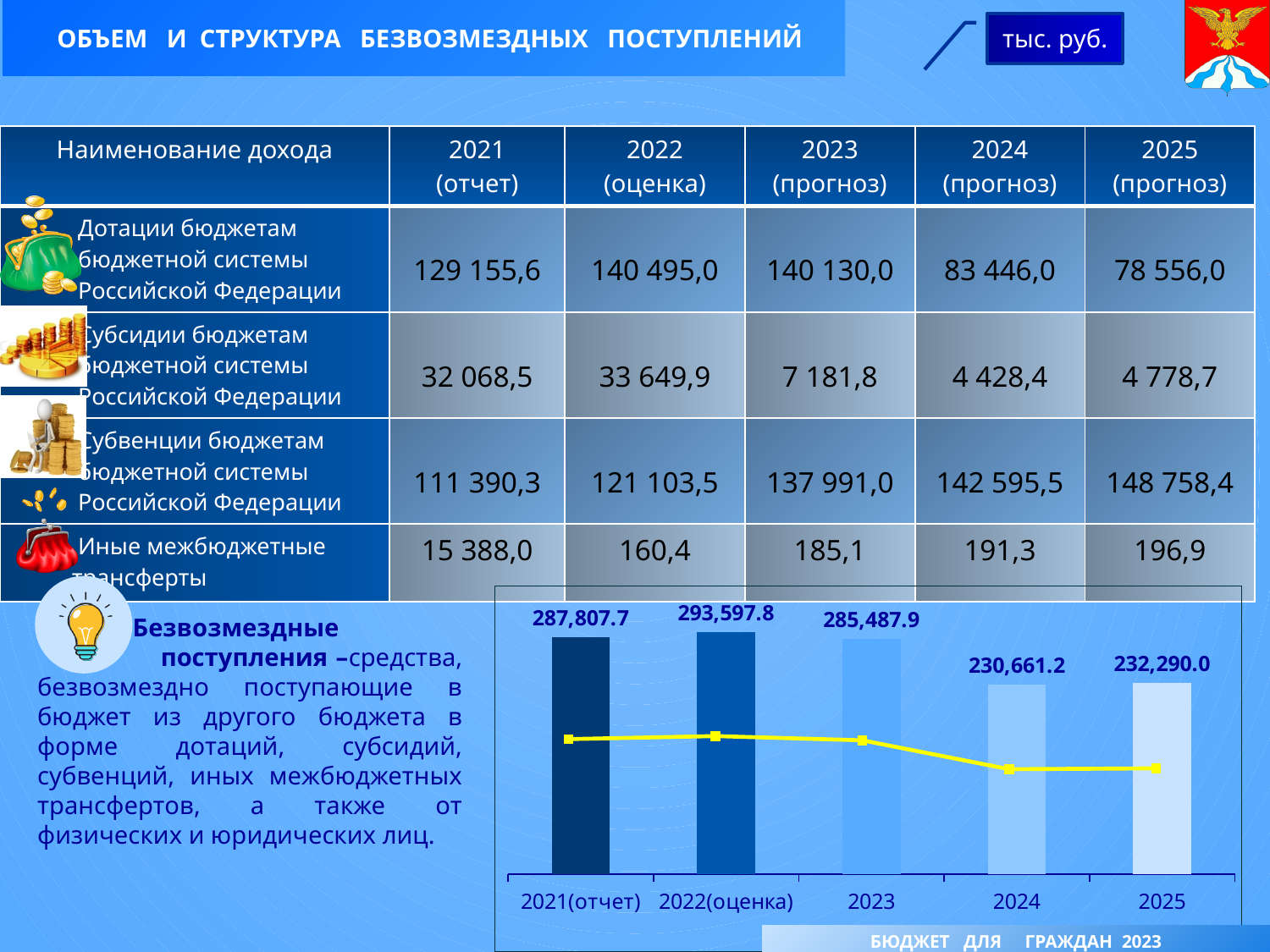
What is the value of the bar for 2021(отчет) in the chart? 287,807.7 Which bar is larger in the chart: 2021(отчет) or 2023? 2021(отчет) What is the difference between the bar values for 2022(оценка) and 2021(отчет)? 5,790.1 Which year has the highest bar in the chart? 2022(оценка) What is the value of the bar for 2024 in the chart? 230,661.2 What is the value of the bar for 2025 in the chart? 232,290.0 Do the bar values rise or fall from 2022(оценка) to 2024? fall What colour is the line plotted over the bars in the chart? yellow What is the value of the bar for 2022(оценка) in the chart at the bottom of the slide? 293,597.8 How many years (categories) are shown on the x axis of the chart? 5 Which year has the lowest bar in the chart? 2024 What is the difference between the bar values for 2025 and 2024? 1,628.8